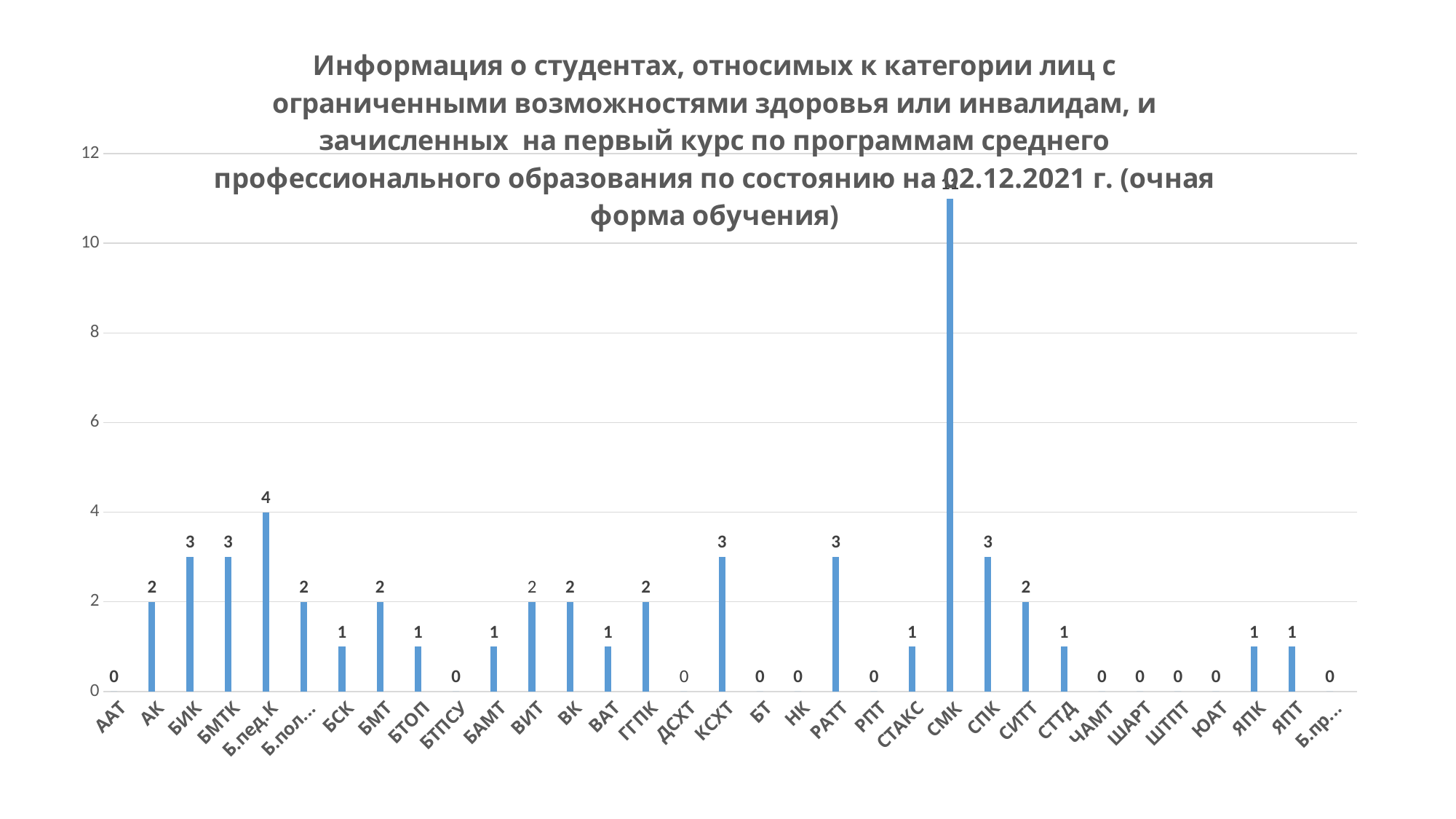
What kind of chart is this? bar chart Which is larger, the value for БИК or the value for АК? БИК How many categories are shown on the x axis? 33 What is the value for Б.пед.К? 4 What is the value for ЯПК? 1 Is the value for СМК greater or less than 10? greater What is the value for КСХТ? 3 What is the value for ЧАМТ? 0 What colour are the bars in the chart? blue What is the difference between the values for Б.пед.К and БСК? 3 What is the value for СИТТ? 2 Which category has the highest value? СМК